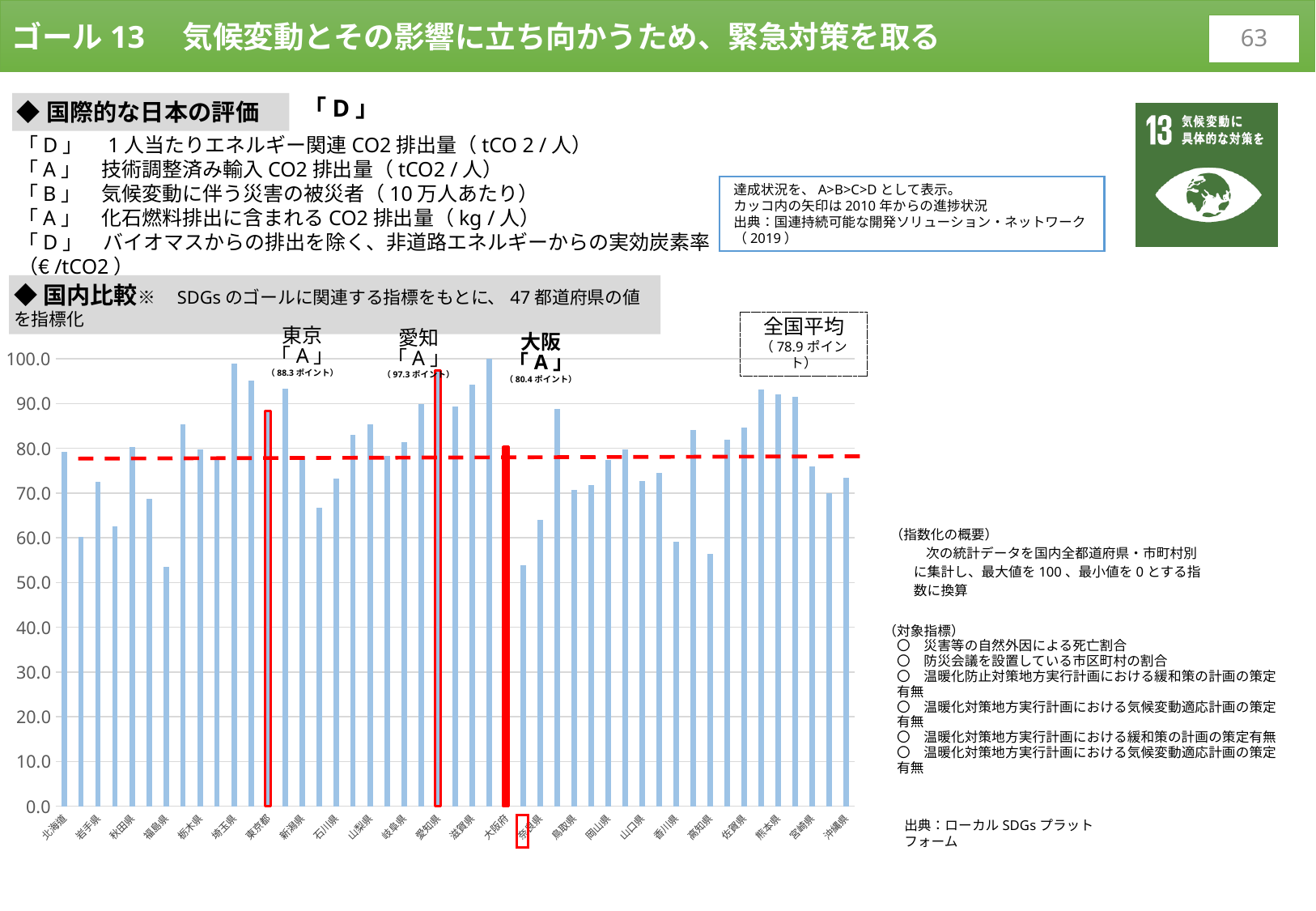
What is the difference between the values for 愛知 and 東京 in the 国内比較 chart? 9.0 ポイント Which has the higher value in the 国内比較 chart, 東京 or 愛知? 愛知 What is the difference between the values for 東京 and 大阪 in the 国内比較 chart? 7.9 ポイント What kind of chart is used for the 国内比較 section? bar chart What is the 全国平均 (national average) value shown on the 国内比較 chart? 78.9 ポイント Is the value for 福島県 in the 国内比較 chart greater or less than 60.0? less What is the value shown for 東京 (Tokyo) in the 国内比較 bar chart? 88.3 ポイント Of the three labelled prefectures 東京, 愛知 and 大阪, which has the lowest value? 大阪 What does the red dashed horizontal line on the 国内比較 chart represent? 全国平均 (78.9 ポイント) What is the value shown for 大阪 (Osaka) in the 国内比較 bar chart? 80.4 ポイント Of the three labelled prefectures 東京, 愛知 and 大阪, which has the highest value? 愛知 What is the value shown for 愛知 (Aichi) in the 国内比較 bar chart? 97.3 ポイント